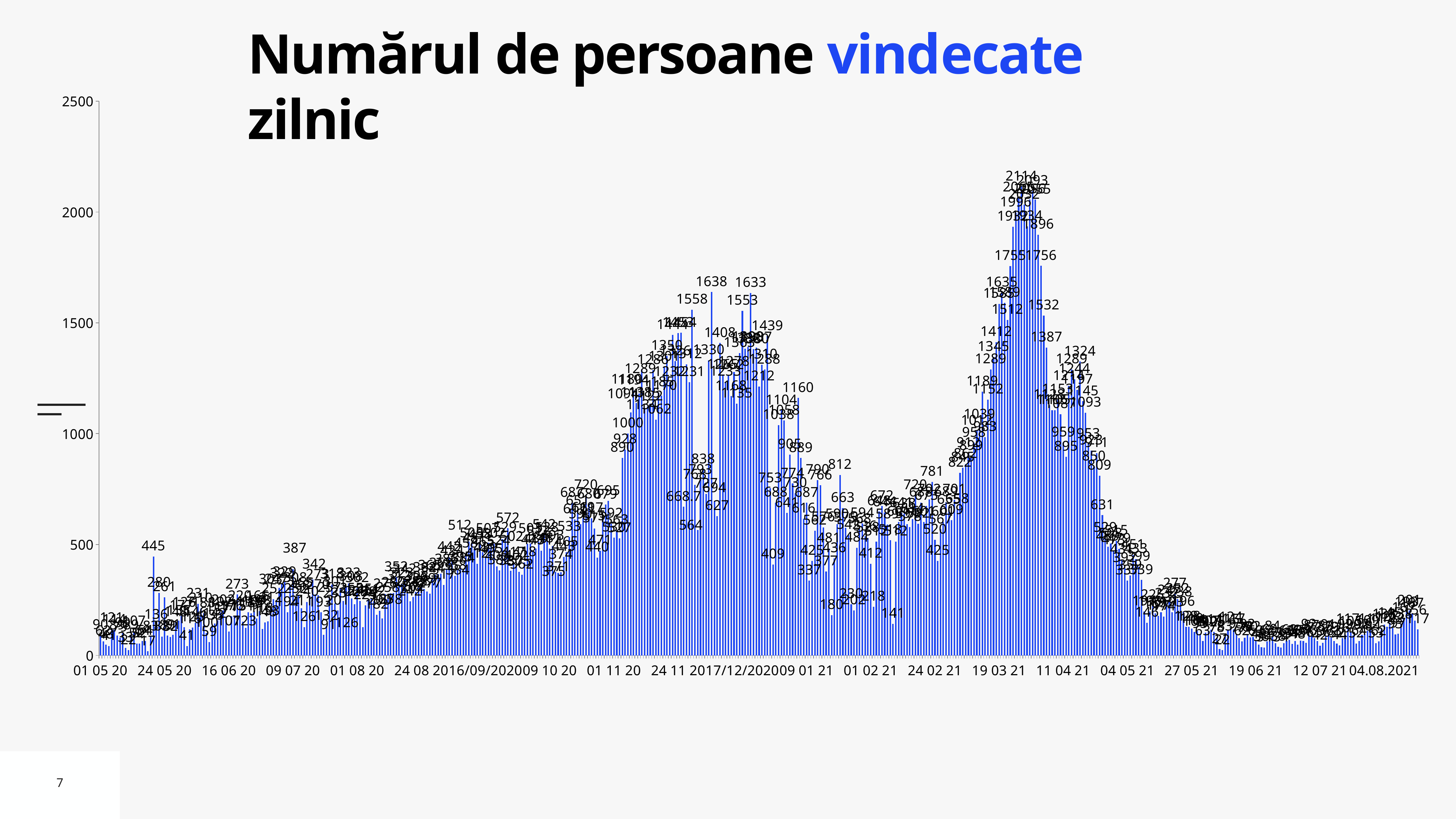
What kind of chart is shown on the slide? bar chart What is the difference between the peak labelled 445 and the peak labelled 387? 58 What is the title of the chart on the slide? Numărul de persoane vindecate zilnic What is the difference between the two tallest labelled bars of the late-2020 peak, 1638 and 1633? 5 Which is larger: the peak labelled 445 near 24 05 20 or the peak labelled 387 near 09 07 20? 445 Is the tallest bar, near the 19 03 21 tick, greater or less than 2000? greater Is the value of the first bar, at 01 05 20, greater or less than 500? less Do the values rise or fall between the 19 03 21 tick and the 04 05 21 tick? fall What is the highest tick value shown on the vertical axis? 2500 Is the value of the last bar, at 04.08.2021, greater or less than 500? less What is the highest value labelled on the chart? 2114 Do the values rise or fall between the 24 02 21 tick and the 19 03 21 tick? rise